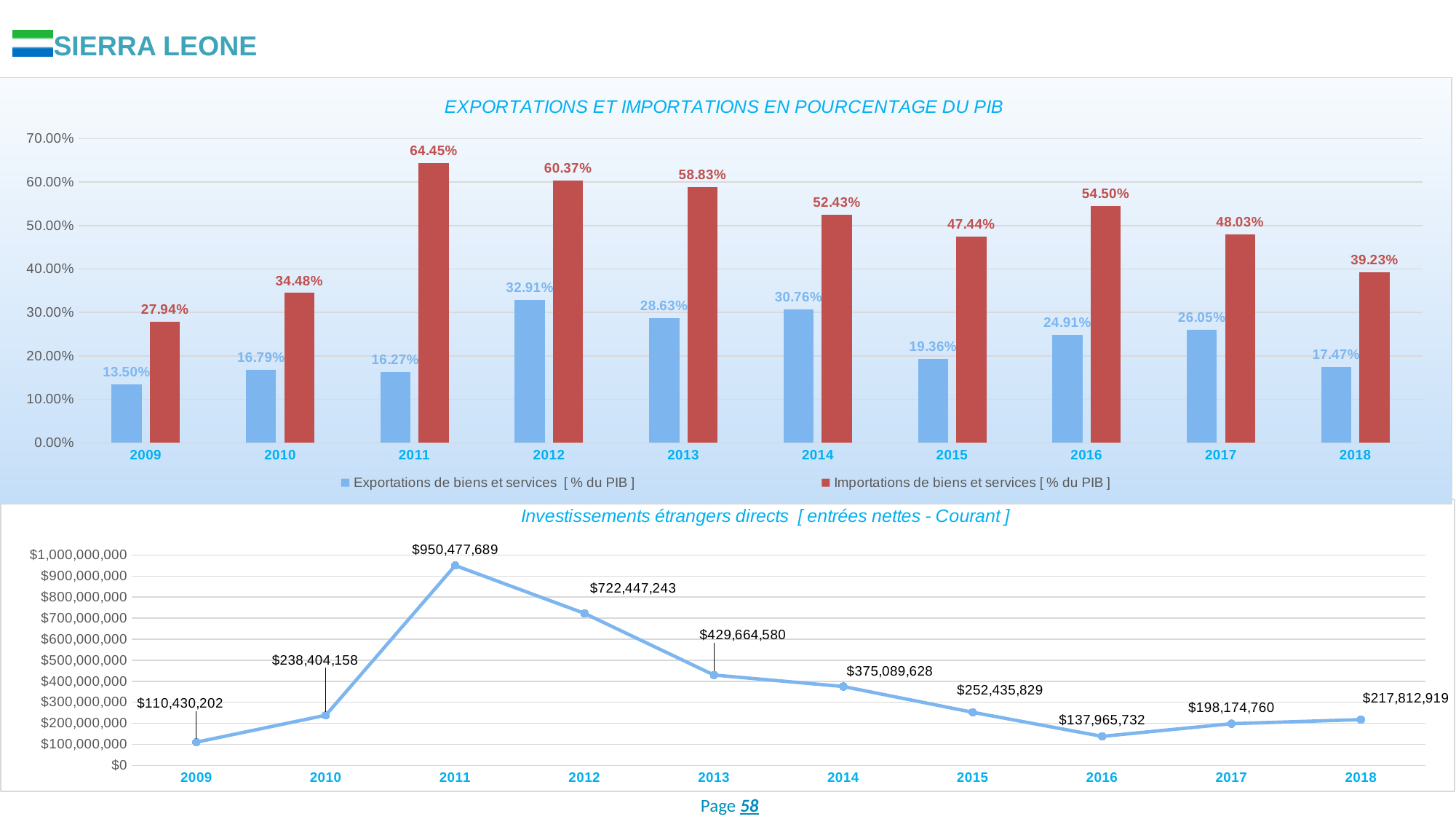
In the chart titled 'EXPORTATIONS ET IMPORTATIONS EN POURCENTAGE DU PIB', what is the value of Importations de biens et services for 2015? 47.44% In the chart titled 'Investissements étrangers directs [ entrées nettes - Courant ]', how many years are plotted? 10 In the chart titled 'EXPORTATIONS ET IMPORTATIONS EN POURCENTAGE DU PIB', what kind of chart is it? Bar chart In the chart titled 'EXPORTATIONS ET IMPORTATIONS EN POURCENTAGE DU PIB', which year has the highest value for Importations de biens et services? 2011 In the chart titled 'EXPORTATIONS ET IMPORTATIONS EN POURCENTAGE DU PIB', what is the difference between Importations and Exportations in 2011? 48.18% In the chart titled 'EXPORTATIONS ET IMPORTATIONS EN POURCENTAGE DU PIB', how many series does the legend list? 2 In the chart titled 'Investissements étrangers directs [ entrées nettes - Courant ]', which year has the lowest value? 2009 In the chart titled 'Investissements étrangers directs [ entrées nettes - Courant ]', do the values rise or fall from 2011 to 2016? Fall In the chart titled 'Investissements étrangers directs [ entrées nettes - Courant ]', is the value for 2016 larger or smaller than the value for 2017? Smaller In the chart titled 'EXPORTATIONS ET IMPORTATIONS EN POURCENTAGE DU PIB', which year has the lowest value for Exportations de biens et services? 2009 In the chart titled 'EXPORTATIONS ET IMPORTATIONS EN POURCENTAGE DU PIB', what is the value of Exportations de biens et services for 2012? 32.91% In the chart titled 'Investissements étrangers directs [ entrées nettes - Courant ]', what is the value for 2011? $950,477,689